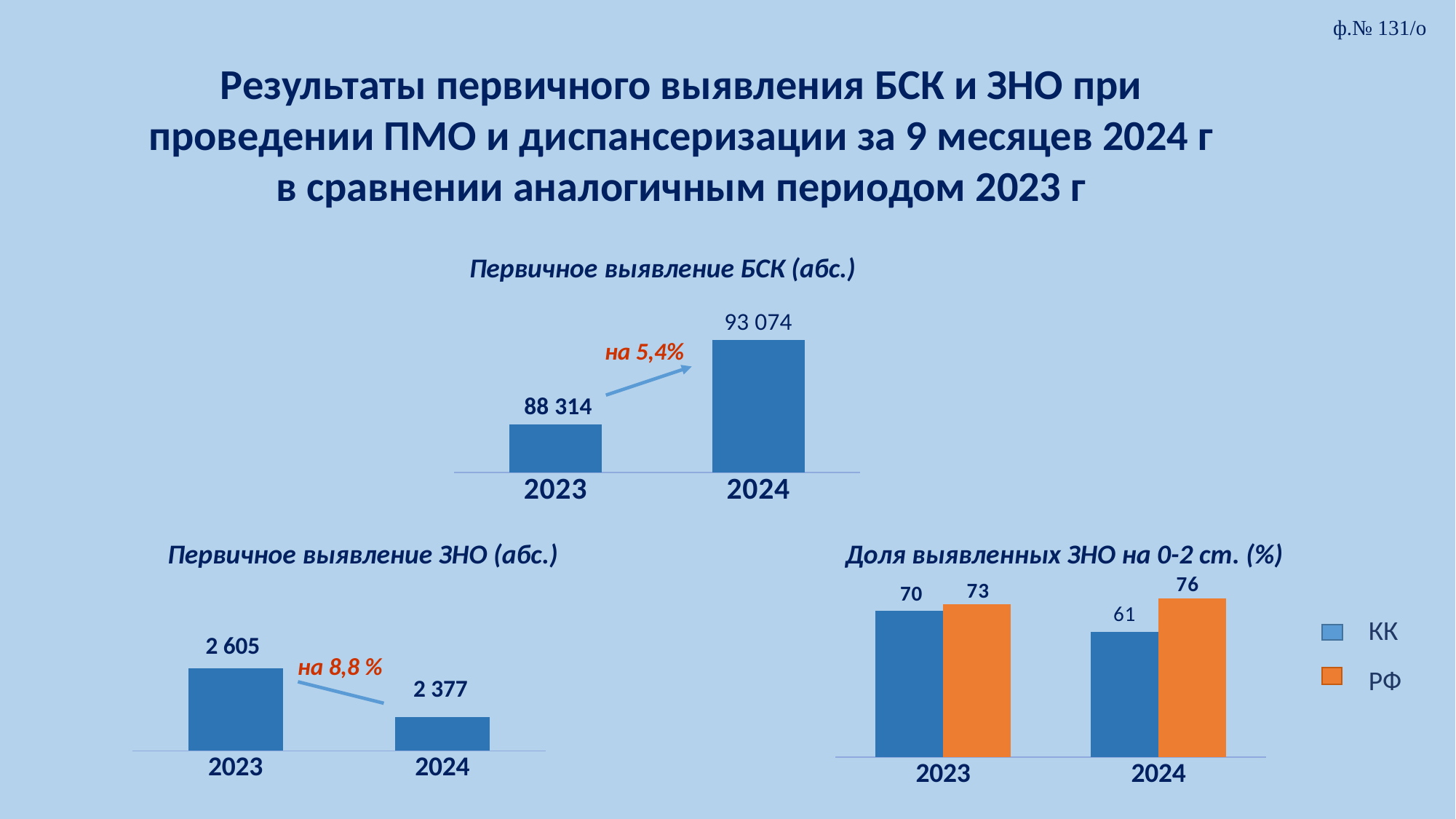
In the chart 'Первичное выявление ЗНО (абс.)', which year has the lower value? 2024 In the chart 'Первичное выявление ЗНО (абс.)', what is the value for 2024? 2 377 In the chart 'Первичное выявление БСК (абс.)', what is the value for 2023? 88 314 In the chart 'Первичное выявление ЗНО (абс.)', what is the difference between the 2023 and 2024 values? 228 In the chart 'Доля выявленных ЗНО на 0-2 ст. (%)', how many series does the legend list? 2 In the chart 'Доля выявленных ЗНО на 0-2 ст. (%)', which is larger in 2024: КК or РФ? РФ In the chart 'Доля выявленных ЗНО на 0-2 ст. (%)', what is the value for КК in 2024? 61 In the chart 'Первичное выявление БСК (абс.)', what is the value for 2024? 93 074 In the chart 'Доля выявленных ЗНО на 0-2 ст. (%)', what is the value for РФ in 2023? 73 In the chart 'Первичное выявление БСК (абс.)', do the values rise or fall from 2023 to 2024? rise In the chart 'Первичное выявление БСК (абс.)', by how much does the 2024 value exceed the 2023 value? 4 760 In the chart 'Первичное выявление ЗНО (абс.)', what is the value for 2023? 2 605